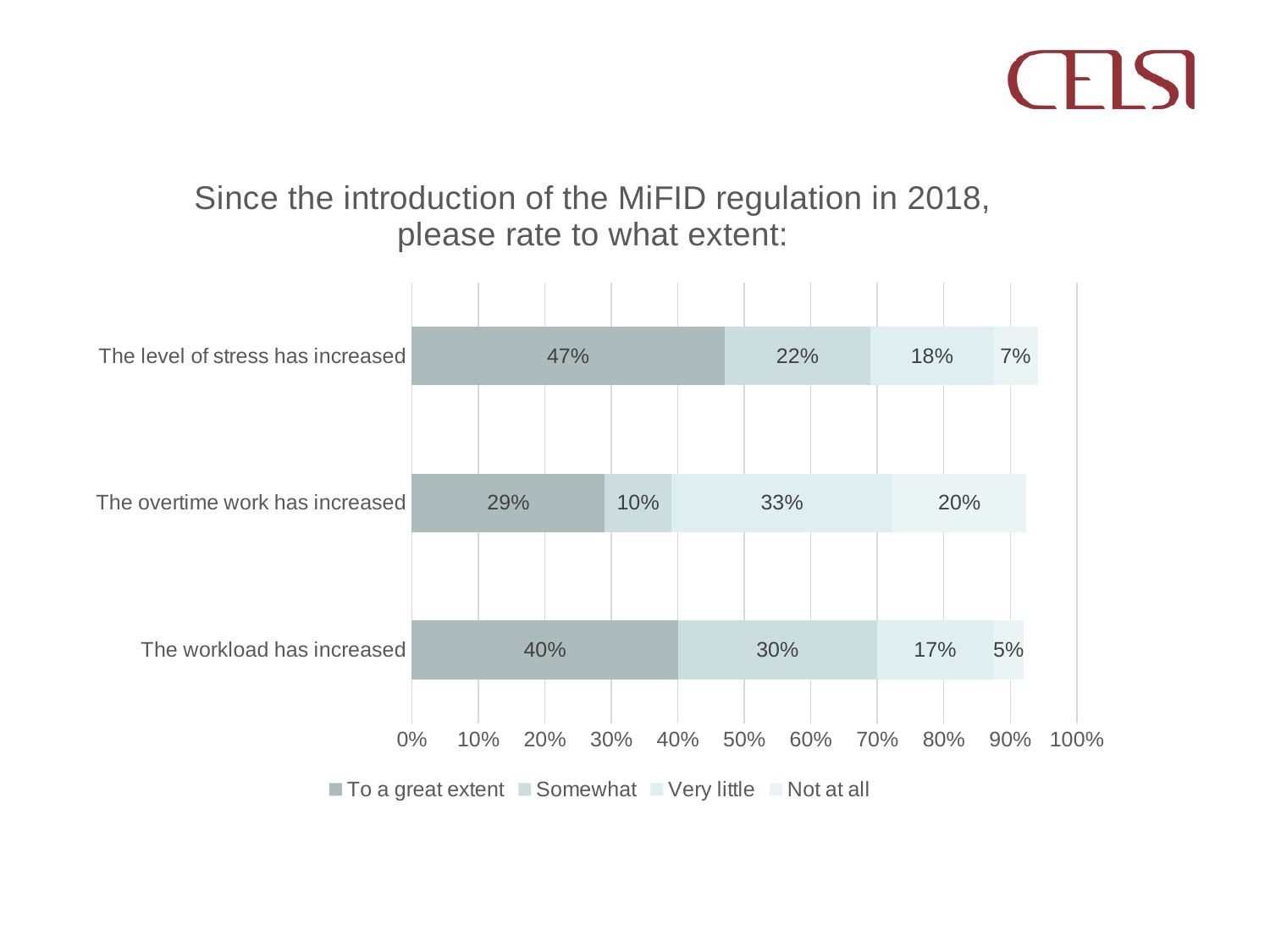
Which is larger: the 'Somewhat' value for 'The workload has increased' or the 'Somewhat' value for 'The level of stress has increased'? The workload has increased What is the total of the stacked bar for 'The level of stress has increased'? 94% What is the last entry in the chart legend? Not at all How many series does the legend list? 4 What percentage of respondents said the level of stress has increased to a great extent? 47% What is the difference between the 'To a great extent' values for 'The level of stress has increased' and 'The workload has increased'? 7% What is the 'Not at all' value for 'The workload has increased'? 5% Which category has the lowest 'Somewhat' value? The overtime work has increased What is the 'Very little' value for 'The overtime work has increased'? 33% How many categories are shown on the y axis? 3 What kind of chart is shown on the slide? Stacked bar chart Which category has the highest 'To a great extent' value? The level of stress has increased